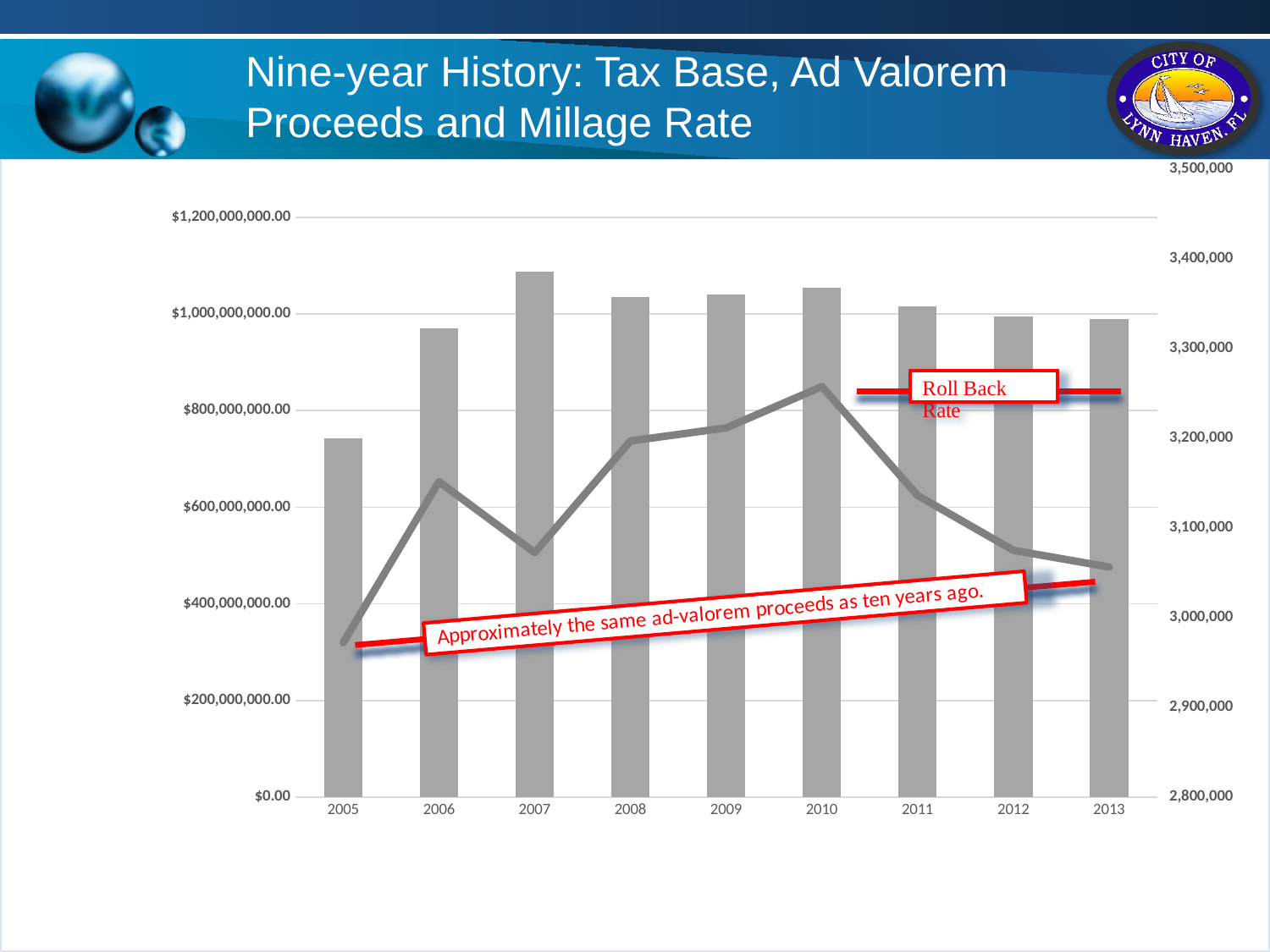
Does the line series rise or fall from 2010 to 2013? fall How many years are shown along the x axis of the chart? 9 Is the bar value for 2007 greater or less than $1,000,000,000.00? greater Is the bar value for 2006 greater or less than $1,000,000,000.00? less Which year has the tallest bar in the chart? 2007 In which year does the line series reach its highest point? 2010 In which year is the line series at its lowest point? 2005 Which year has the shortest bar in the chart? 2005 Which year has a taller bar, 2005 or 2006? 2006 What kind of chart is shown on the slide? A combined bar and line chart Is the bar value for 2005 greater or less than $800,000,000.00? less